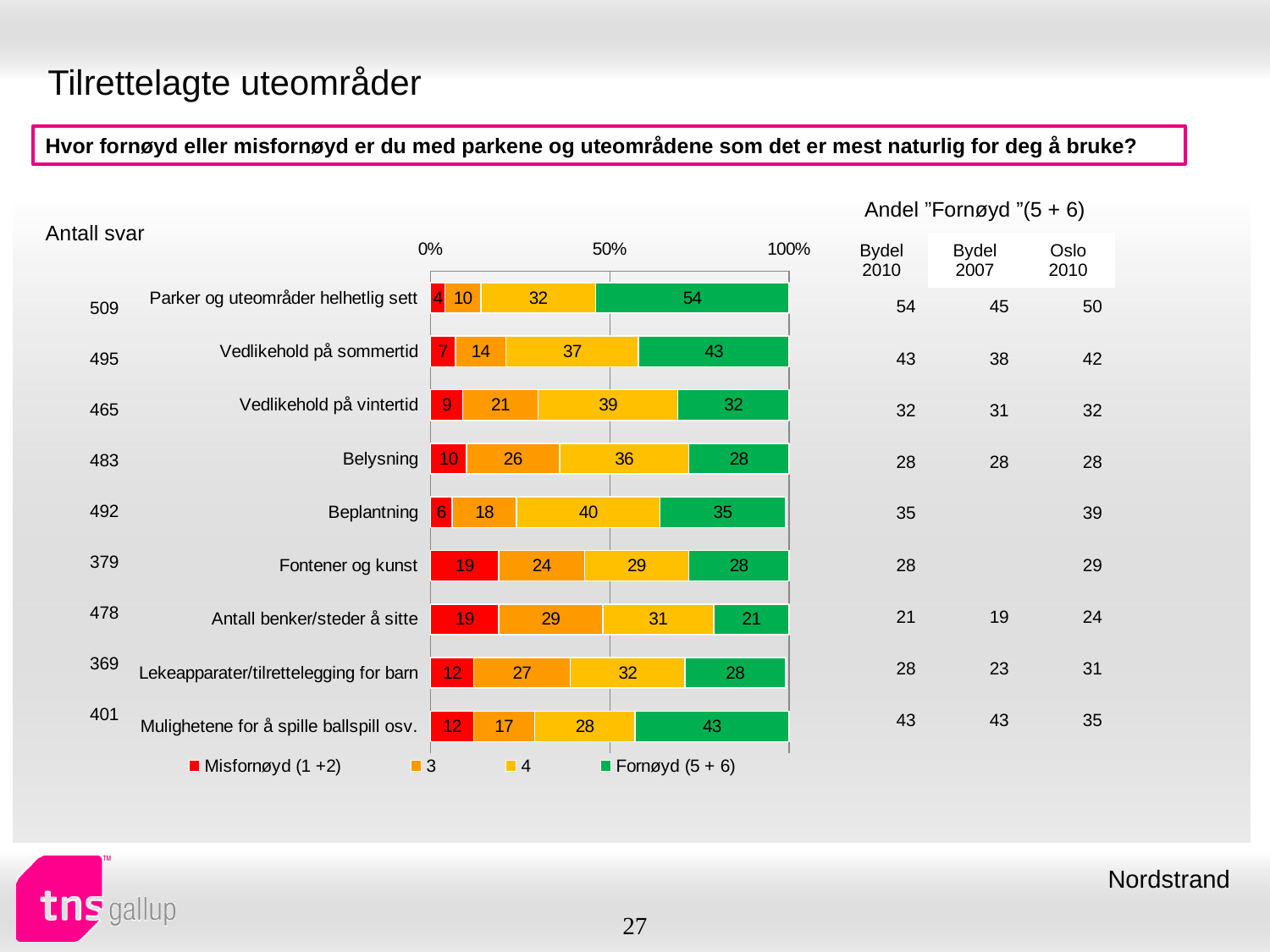
What is the "Fornøyd (5 + 6)" value for "Parker og uteområder helhetlig sett"? 54 How many categories are shown in the bar chart? 9 What is the value of series "3" for "Antall benker/steder å sitte"? 29 How many series does the chart legend list? 4 What is the value of series "4" for "Beplantning"? 40 Which category has the lowest "Fornøyd (5 + 6)" value? Antall benker/steder å sitte What is the difference between the "Fornøyd (5 + 6)" values for "Vedlikehold på sommertid" and "Vedlikehold på vintertid"? 11 Which category has the highest "Fornøyd (5 + 6)" value? Parker og uteområder helhetlig sett What is the "Misfornøyd (1 +2)" value for "Fontener og kunst"? 19 Which is larger: the "Misfornøyd (1 +2)" value for "Belysning" or for "Beplantning"? Belysning What type of chart is shown on the slide? Stacked bar chart Which colour represents "Fornøyd (5 + 6)" in the chart? Green